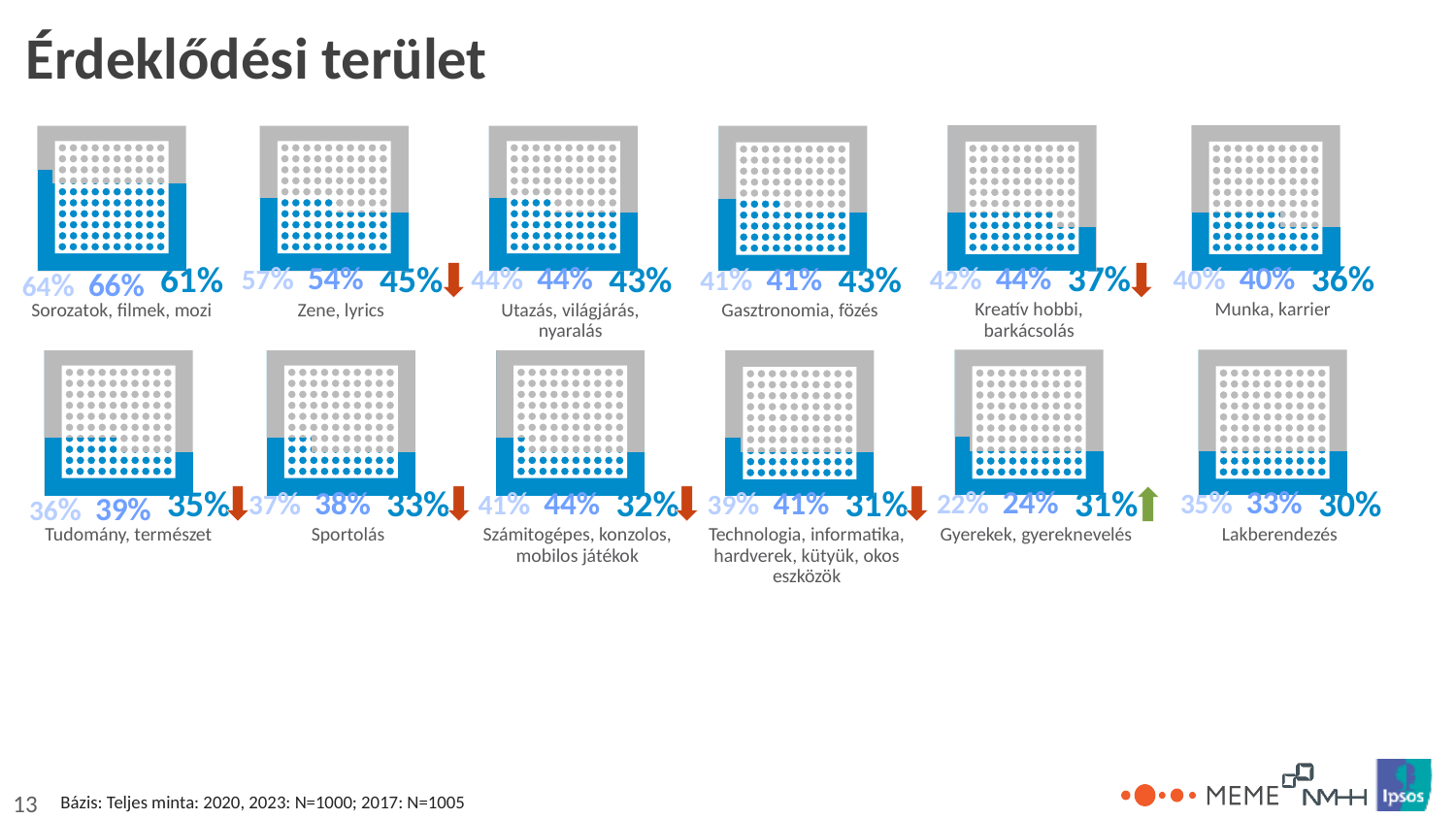
Which category has the lowest rightmost (bold) percentage on the slide? Lakberendezés Which has a larger rightmost (bold) percentage: 'Gasztronomia, főzés' or 'Munka, karrier'? Gasztronomia, főzés Which category has the highest rightmost (bold) percentage on the slide? Sorozatok, filmek, mozi What is the rightmost (largest, bold) percentage shown for 'Gyerekek, gyereknevelés'? 31% How many interest categories (charts) are shown on the slide? 12 What is the difference between the rightmost (bold) percentages of 'Zene, lyrics' and 'Sportolás'? 12% Which category is marked with a green upward arrow? Gyerekek, gyereknevelés What kind of chart is used for each category on the slide? Pictograph (waffle/dot chart) What is the rightmost (largest, bold) percentage shown for 'Sorozatok, filmek, mozi'? 61% What is the rightmost (largest, bold) percentage shown for 'Lakberendezés'? 30% What is the middle percentage shown for 'Zene, lyrics'? 54% Do the three percentages for 'Gyerekek, gyereknevelés' rise or fall from left to right? Rise